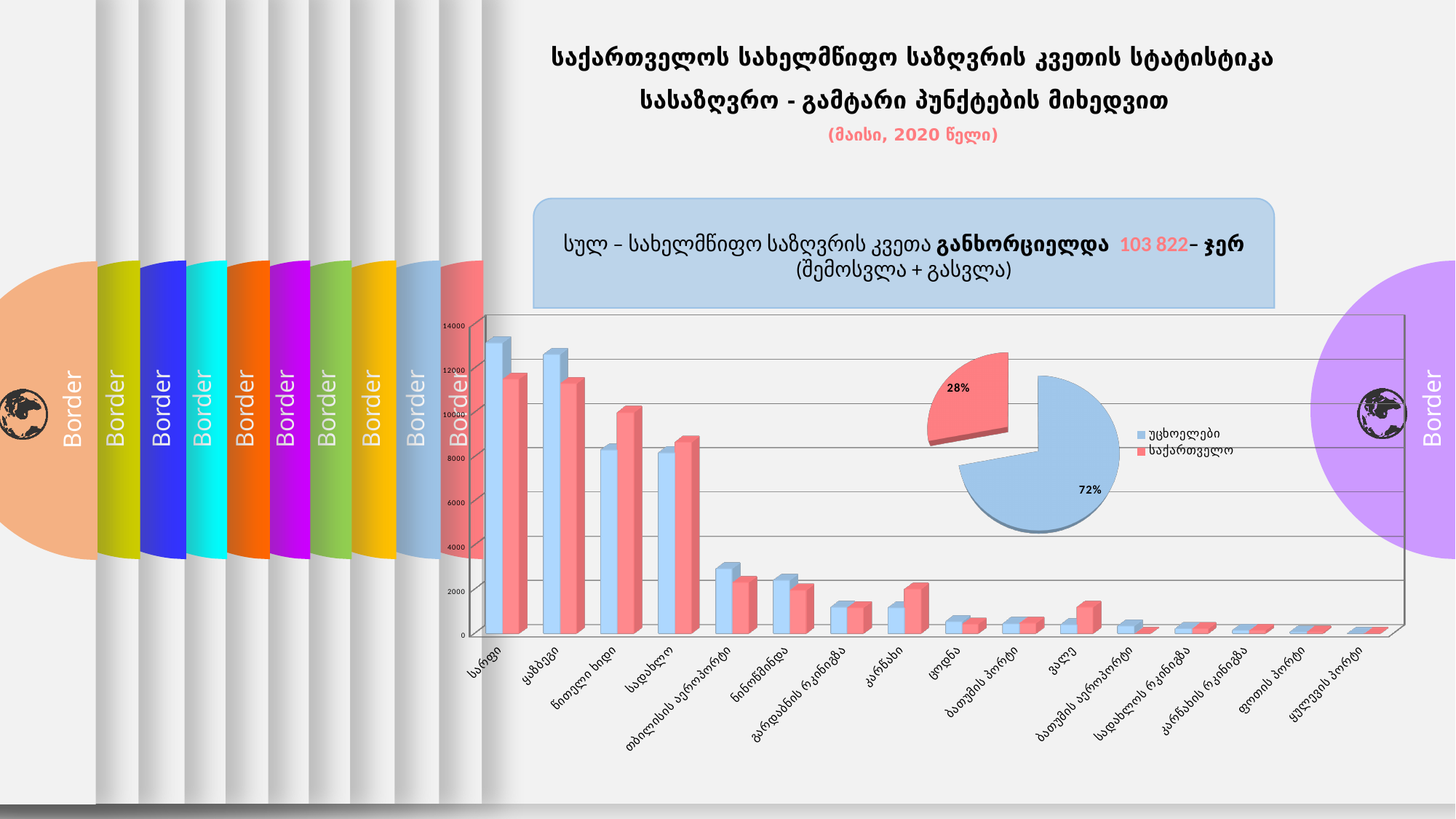
In the pie chart, what share does the საქართველო slice have? 28% In the pie chart, what share does the უცხოელები slice have? 72% How many series does the legend of the pie chart list? 2 In the pie chart, what is the difference in percentage points between the უცხოელები slice and the საქართველო slice? 44 What kind of chart is the smaller chart on the right side of the slide? pie chart How many categories are shown on the x axis of the bar chart? 16 What kind of chart is the large chart on the left side of the slide? bar chart In the pie chart, which slice is larger, უცხოელები or საქართველო? უცხოელები